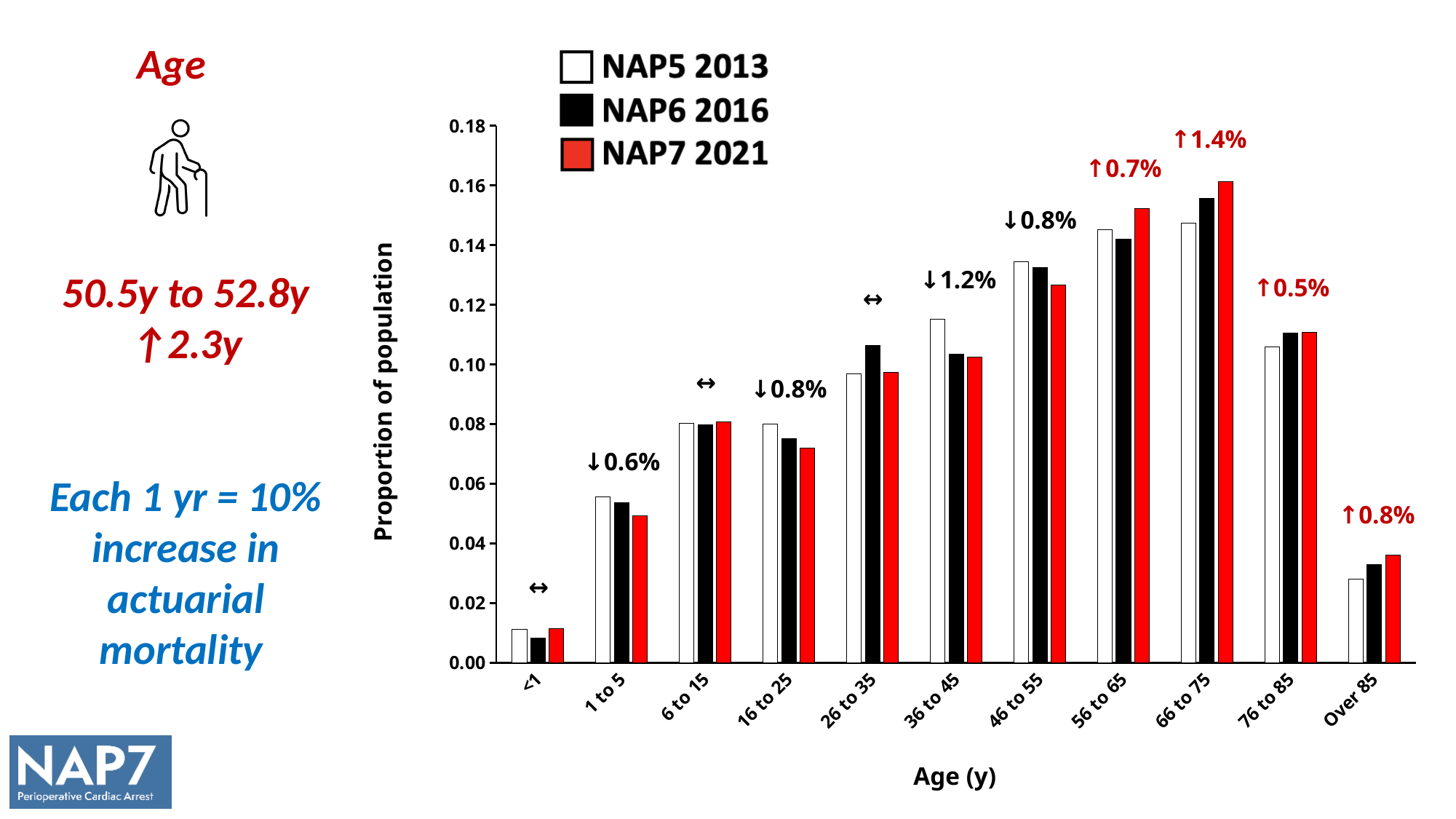
Is the NAP7 2021 value for 66 to 75 greater or less than 0.14? greater How many series does the legend list? 3 What change is annotated above the 66 to 75 age group? ↑1.4% Is the NAP6 2016 value for 26 to 35 greater or less than 0.10? greater What kind of chart is shown on the slide? Bar chart Which age category has the lowest NAP6 2016 value? <1 What is the label of the y axis? Proportion of population Is the NAP7 2021 value for 1 to 5 greater or less than 0.06? less Which age category has the highest NAP7 2021 value? 66 to 75 How many age categories are shown on the x axis? 11 For the Over 85 age group, which is larger: the NAP5 2013 value or the NAP7 2021 value? NAP7 2021 For the 36 to 45 age group, which is larger: the NAP5 2013 value or the NAP7 2021 value? NAP5 2013